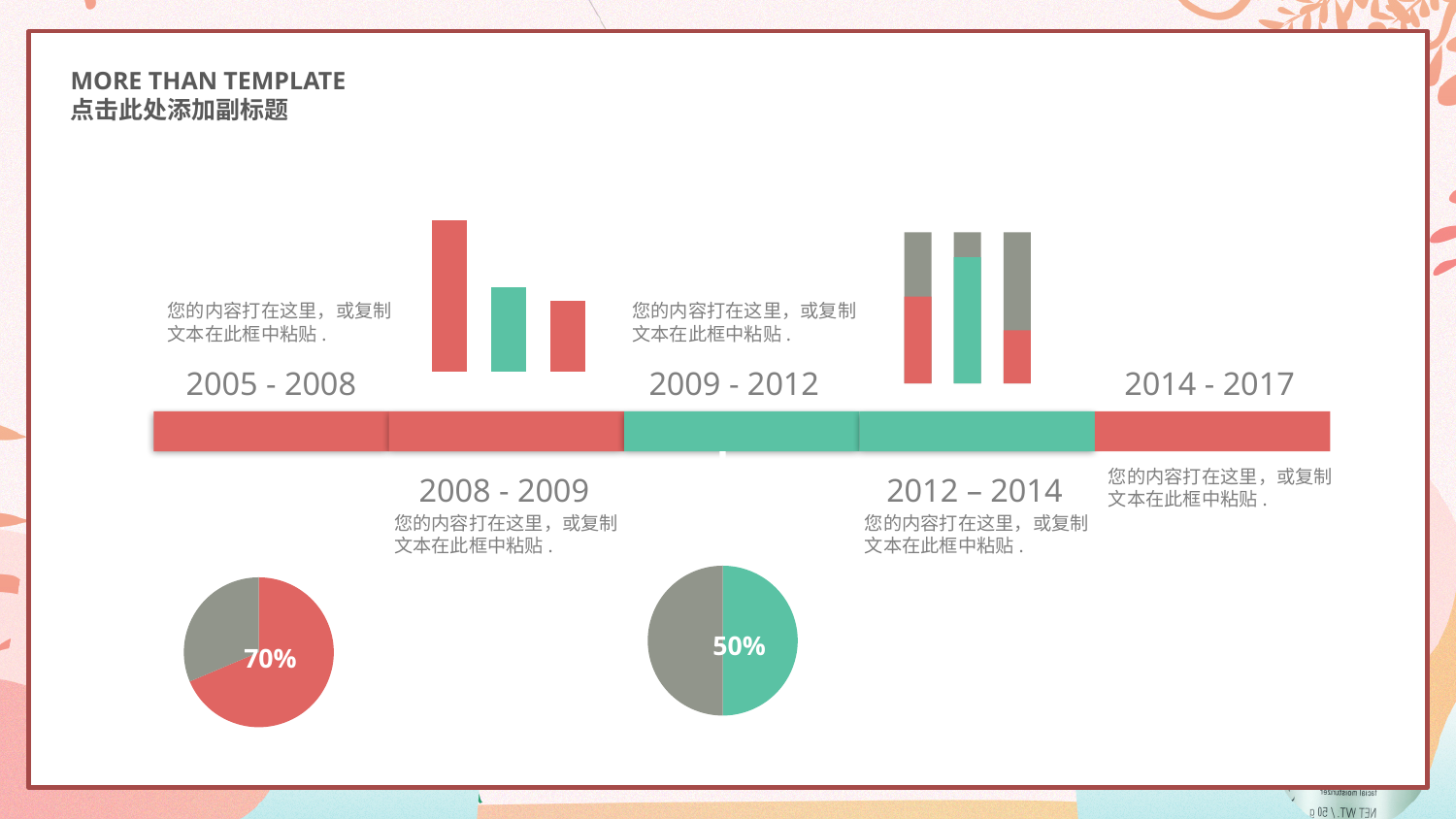
What kind of chart is the chart below the 2008 - 2009 label? pie chart How many bars are in the stacked bar chart above the timeline between 2009 - 2012 and 2014 - 2017? 3 Which pie chart shows the larger percentage: the one below 2008 - 2009 or the one below 2012 – 2014? the one below 2008 - 2009 What kind of chart is the chart above the timeline between 2009 - 2012 and 2014 - 2017? stacked bar chart In the stacked bar chart above the timeline between 2009 - 2012 and 2014 - 2017, which bar has the largest coloured (non-grey) segment: the first, second or third? the second What percentage is shown on the pie chart below the 2008 - 2009 label? 70% How many bars are in the bar chart above the timeline between 2005 - 2008 and 2009 - 2012? 3 In the bar chart above the timeline between 2005 - 2008 and 2009 - 2012, which bar is the shortest: the first, second or third? the third What kind of chart is the chart above the timeline between 2005 - 2008 and 2009 - 2012? bar chart In the bar chart above the timeline between 2005 - 2008 and 2009 - 2012, is the first bar or the second bar taller? the first bar In the bar chart above the timeline between 2005 - 2008 and 2009 - 2012, which bar is the tallest: the first, second or third? the first What percentage is shown on the pie chart below the 2012 – 2014 label? 50%